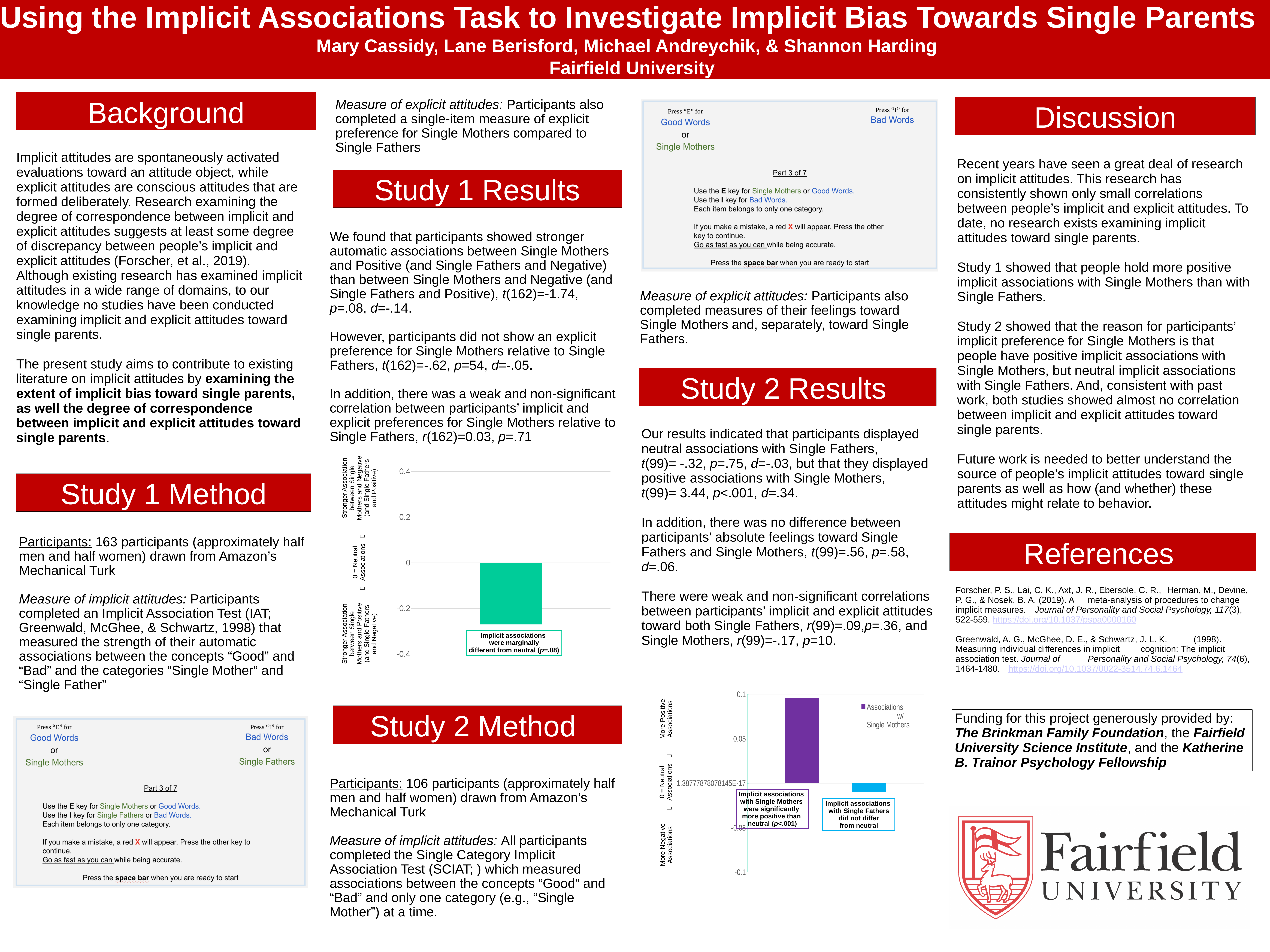
In the Study 2 Results chart, which bar is higher: Single Mothers or Single Fathers? Single Mothers In the Study 2 Results chart, is the value of the Single Fathers bar greater or less than 0.05? less In the Study 2 Results chart, how many bars are plotted? 2 In the Study 1 Results chart, is the value of the bar greater or less than -0.2? less In the Study 2 Results chart, what is the legend entry shown? Associations w/ Single Mothers In the Study 1 Results chart, what p-value is given in the annotation box below the bar? p=.08 In the Study 2 Results chart, is the value of the Single Mothers bar greater or less than 0.05? greater In the Study 1 Results chart, what kind of chart is shown? bar chart In the Study 1 Results chart, how many bars are plotted? 1 In the Study 2 Results chart, what kind of chart is shown? bar chart In the Study 2 Results chart, what is the highest tick value shown on the y axis? 0.1